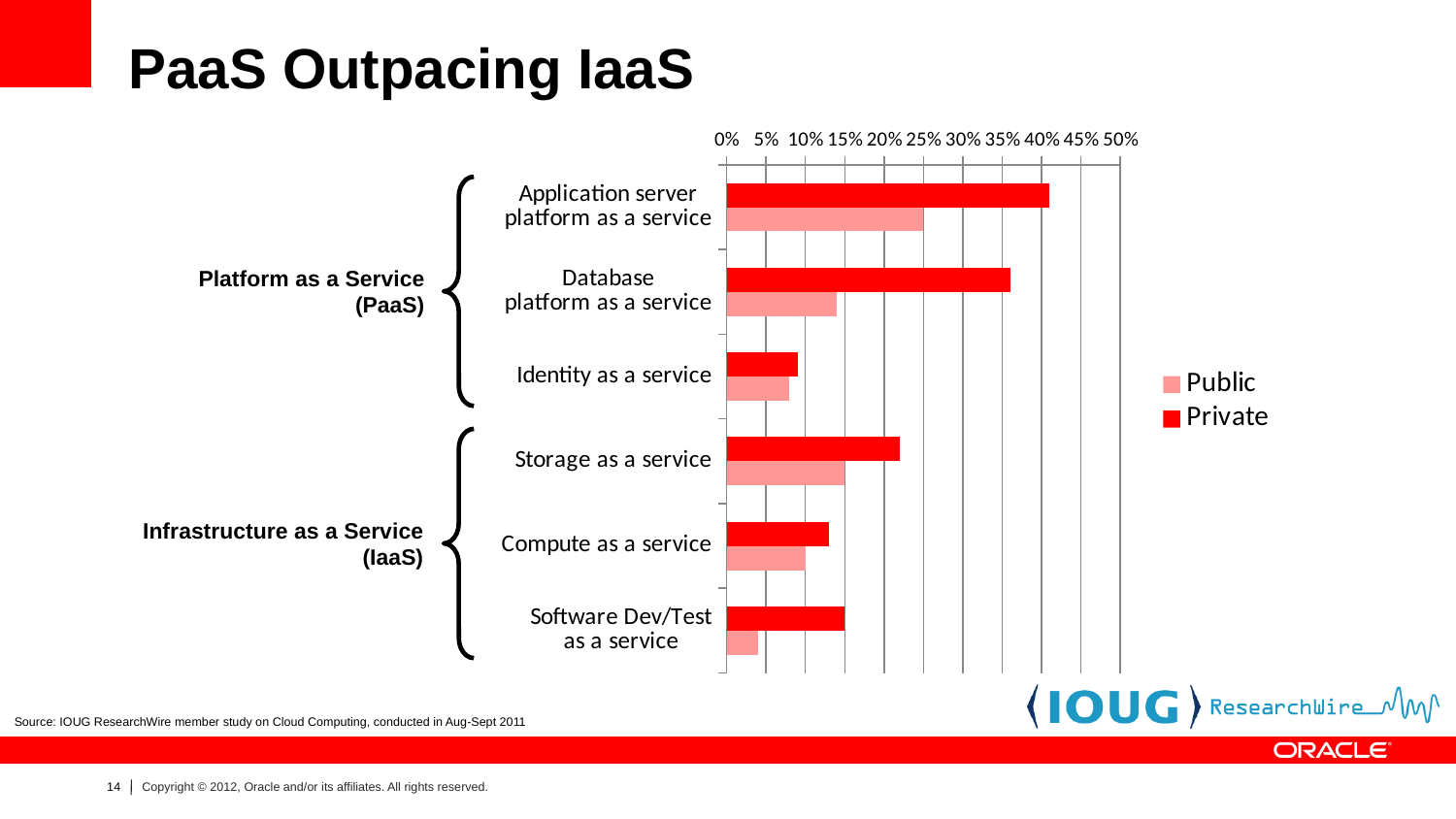
Is the Private value for Storage as a service greater or less than 20%? greater Which series is shown in the darker red colour in the legend? Private For Database platform as a service, which is larger, the Public or the Private value? Private Is the Public value for Software Dev/Test as a service greater or less than 10%? less Which category has the lowest Private value? Identity as a service Which is larger, the Private value for Storage as a service or the Private value for Compute as a service? Storage as a service How many series does the legend list? 2 Which category has the highest Private value? Application server platform as a service How many categories are plotted on the chart? 6 Is the Private value for Application server platform as a service greater or less than 35%? greater What kind of chart is shown on the slide? bar chart Which category has the lowest Public value? Software Dev/Test as a service